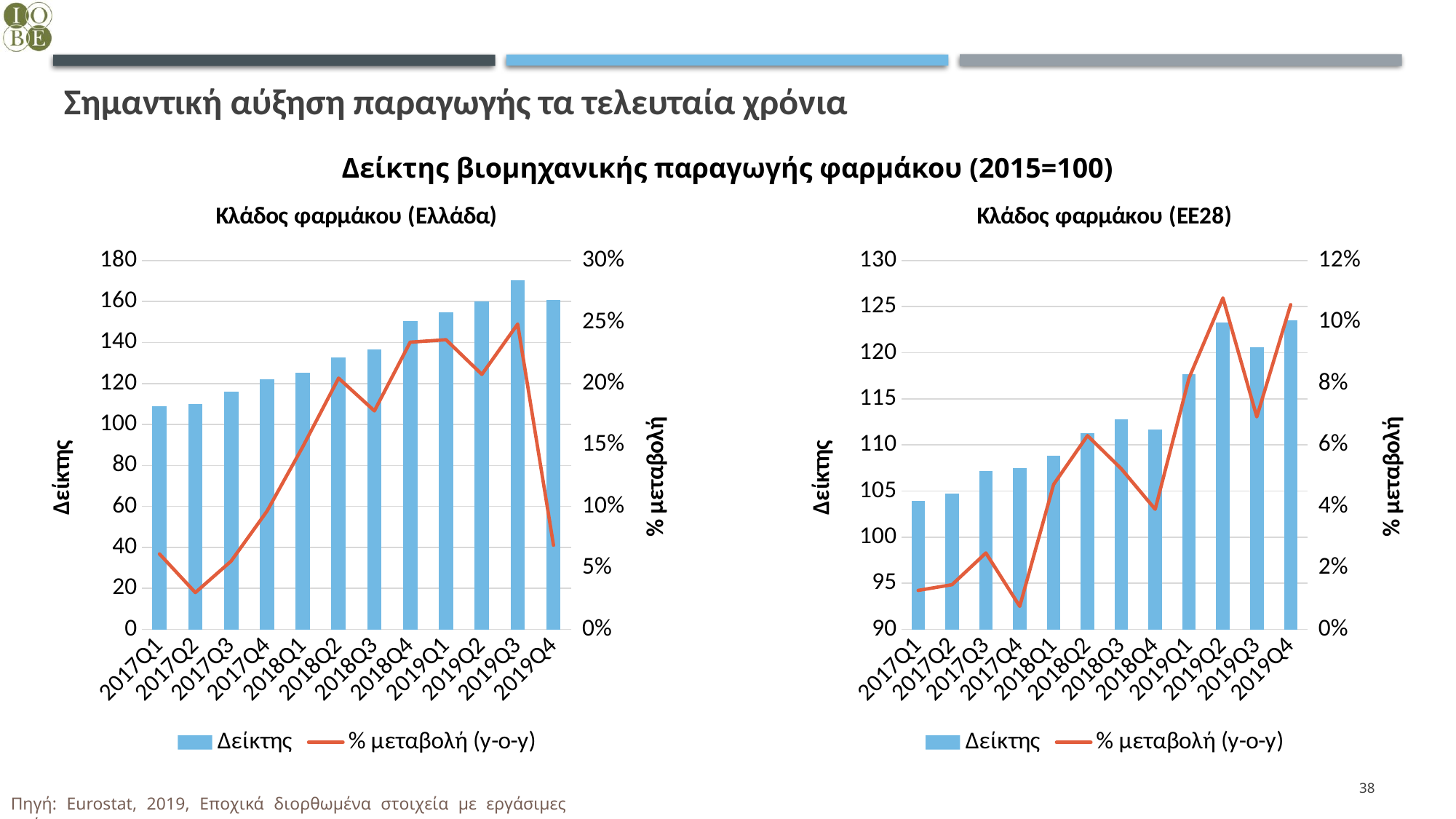
In the right chart (ΕΕ28), is the Δείκτης value for 2019Q1 greater or less than 115? greater In the left chart (Ελλάδα), is the % μεταβολή (y-o-y) value for 2019Q4 greater or less than 10%? less In the left chart (Ελλάδα), is the Δείκτης bar for 2019Q3 higher or lower than the bar for 2019Q4? higher In the left chart (Ελλάδα), is the Δείκτης value for 2019Q3 greater or less than 160? greater What is the overall title shown above both charts? Δείκτης βιομηχανικής παραγωγής φαρμάκου (2015=100) What kind of chart is the left chart titled 'Κλάδος φαρμάκου (Ελλάδα)'? Combined bar and line chart In the right chart (ΕΕ28), in which quarter is the % μεταβολή (y-o-y) line at its lowest? 2017Q4 How many series does the legend of the right chart (ΕΕ28) list? 2 In the left chart (Ελλάδα), which quarter has the highest Δείκτης bar? 2019Q3 In the right chart (ΕΕ28), is the Δείκτης bar for 2019Q2 higher or lower than the bar for 2019Q3? higher In the left chart (Ελλάδα), in which quarter is the % μεταβολή (y-o-y) line at its lowest? 2017Q2 How many quarters are shown on the x axis of the right chart (ΕΕ28)? 12